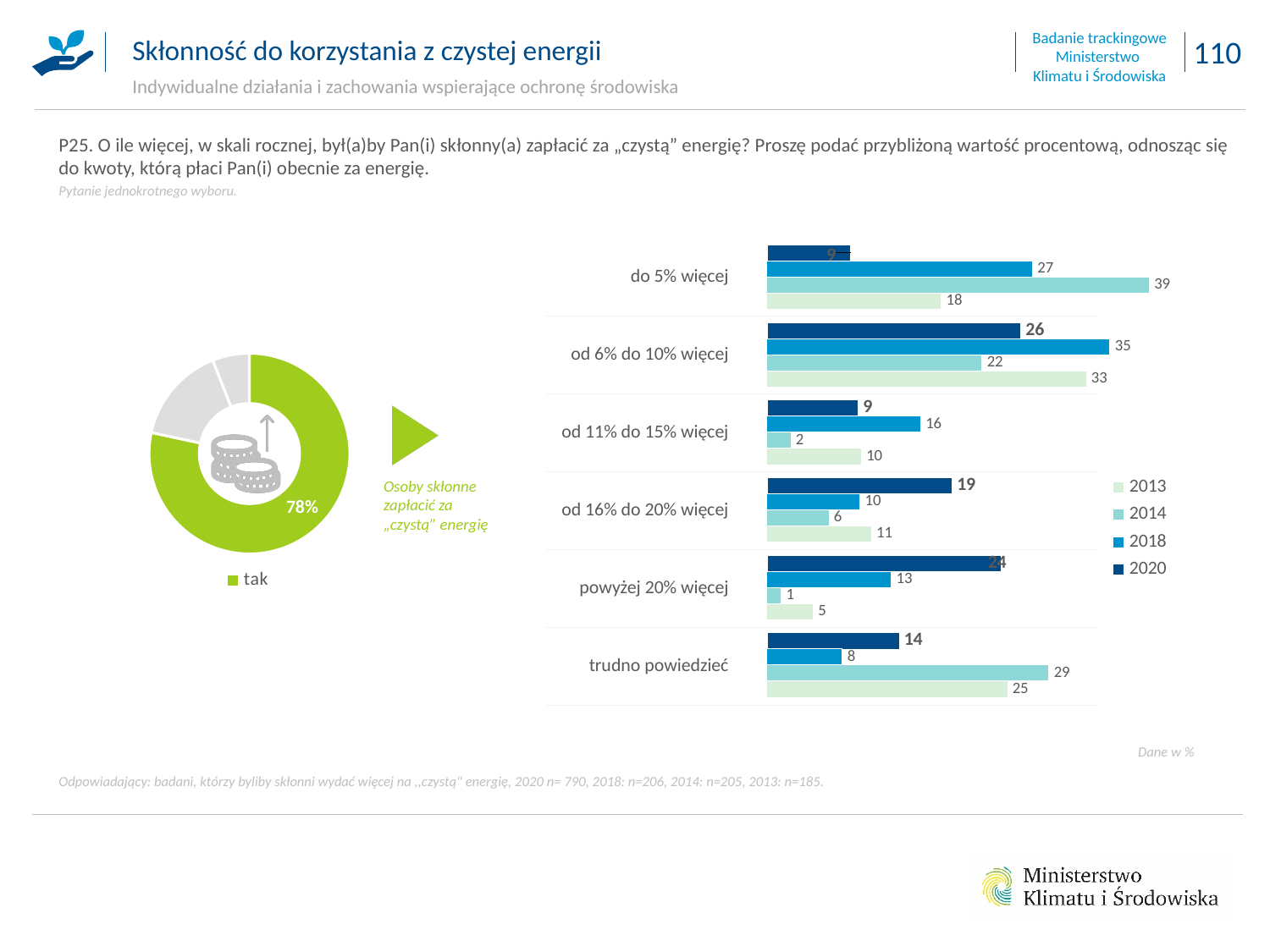
In the bar chart on the right, what is the difference between the 2018 and 2014 values for "od 6% do 10% więcej"? 13 In the bar chart on the right, what is the 2020 value for "od 16% do 20% więcej"? 19 In the bar chart on the right, how many categories are shown? 6 In the bar chart on the right, what is the 2018 value for "od 6% do 10% więcej"? 35 In the donut chart on the left, what percentage is shown for "tak"? 78% In the bar chart on the right, which category has the lowest 2014 value? powyżej 20% więcej In the bar chart on the right, which years are listed in the legend? 2013, 2014, 2018, 2020 In the bar chart on the right, how many series does the legend list? 4 What kind of chart is the chart on the right showing the categories from "do 5% więcej" to "trudno powiedzieć"? bar chart In the bar chart on the right, what is the 2014 value for "do 5% więcej"? 39 In the bar chart on the right, which category has the highest 2014 value? do 5% więcej In the bar chart on the right, for "trudno powiedzieć", which is larger: the 2014 value or the 2013 value? 2014